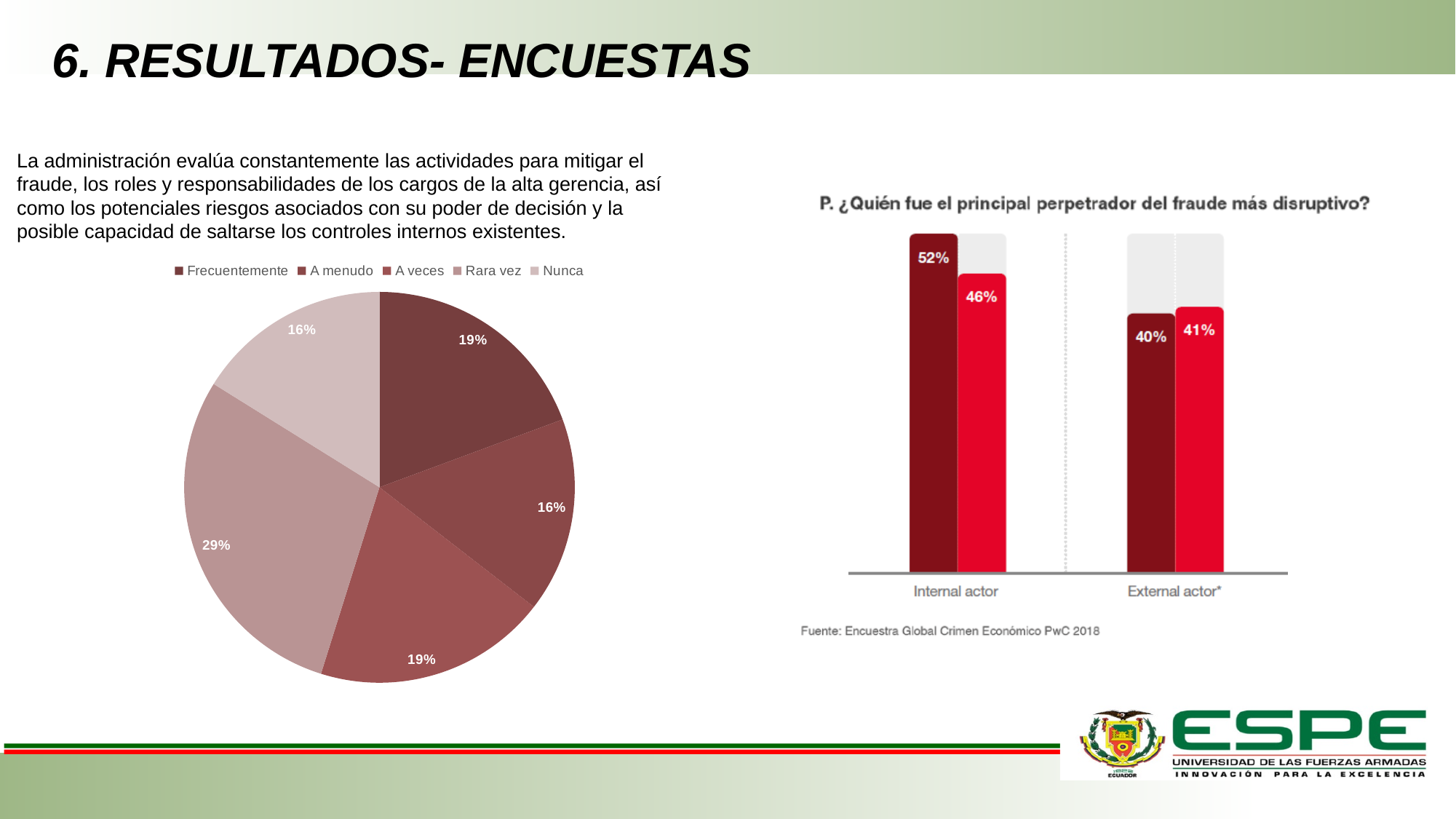
In the pie chart on the left, what share does 'Nunca' have? 16% What type of chart is the right chart titled 'P. ¿Quién fue el principal perpetrador del fraude más disruptivo?'? bar chart In the pie chart on the left, which category has the largest slice? Rara vez In the pie chart on the left, what share does 'Rara vez' have? 29% In the right chart, what is the value of the bright red (right) bar for 'External actor*'? 41% In the right chart, what is the difference between the two bars for 'Internal actor'? 6% How many categories does the legend of the pie chart on the left list? 5 In the pie chart on the left, what is the difference between the 'Rara vez' share and the 'A menudo' share? 13% In the pie chart on the left, what share does 'Frecuentemente' have? 19% In the right chart, how many categories are shown on the x axis? 2 What type of chart is the left chart on the slide? pie chart In the right chart, what is the value of the dark red (left) bar for 'Internal actor'? 52%